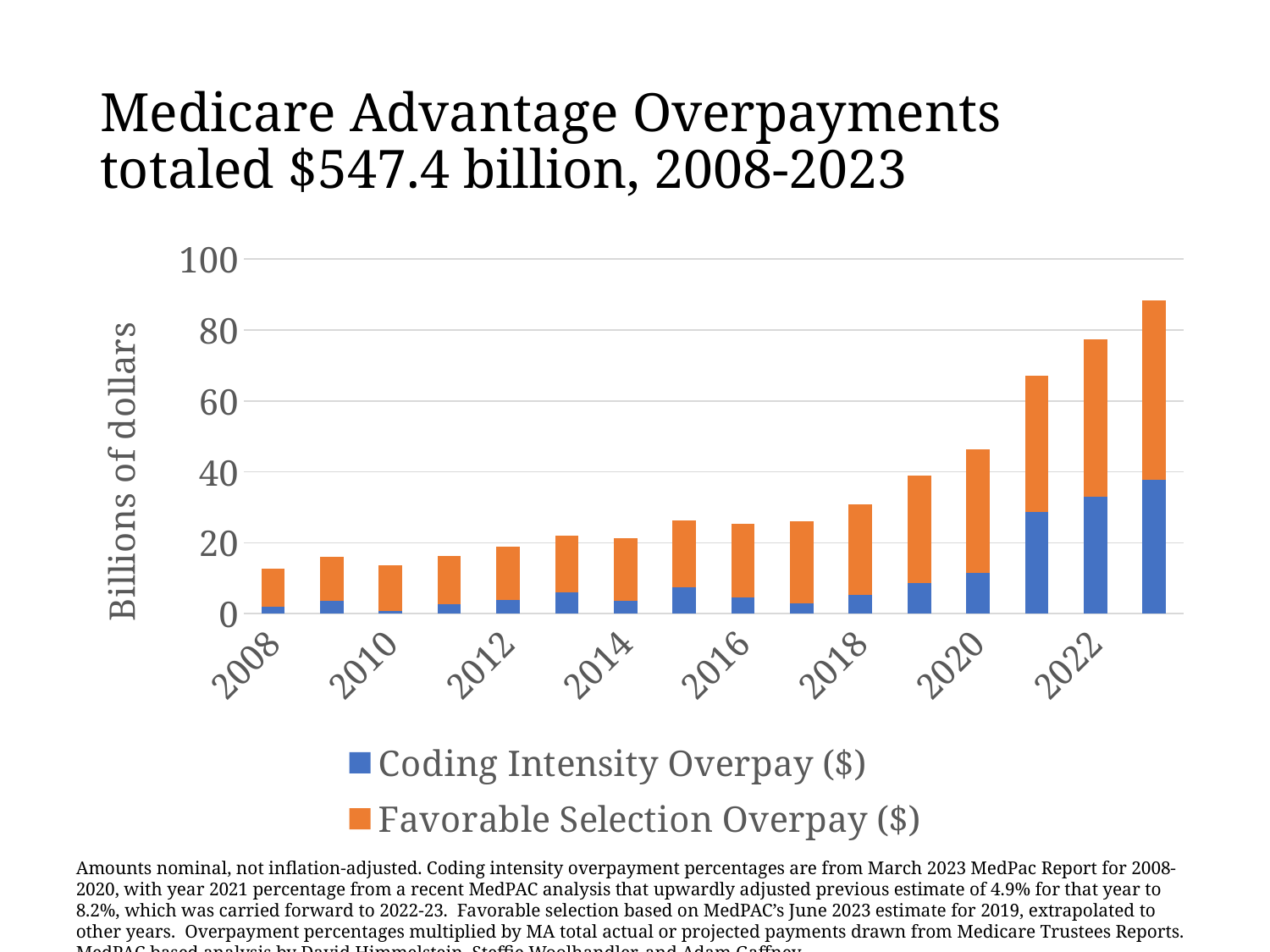
Is the total overpayment for 2008 greater or less than 20 billion dollars? less What is the label on the vertical axis? Billions of dollars Which year has the larger total overpayment, 2017 or 2019? 2019 Which colour represents Coding Intensity Overpay ($) in the chart? blue How many years (bars) are plotted in the chart? 16 What kind of chart is shown on the slide? stacked bar chart Is the total overpayment for 2021 greater or less than 60 billion dollars? greater Which year has the highest total overpayment bar? 2023 Is the total overpayment for 2023 greater or less than 80 billion dollars? greater How many series does the legend list? 2 Do total overpayments generally rise or fall from 2008 to 2023? rise